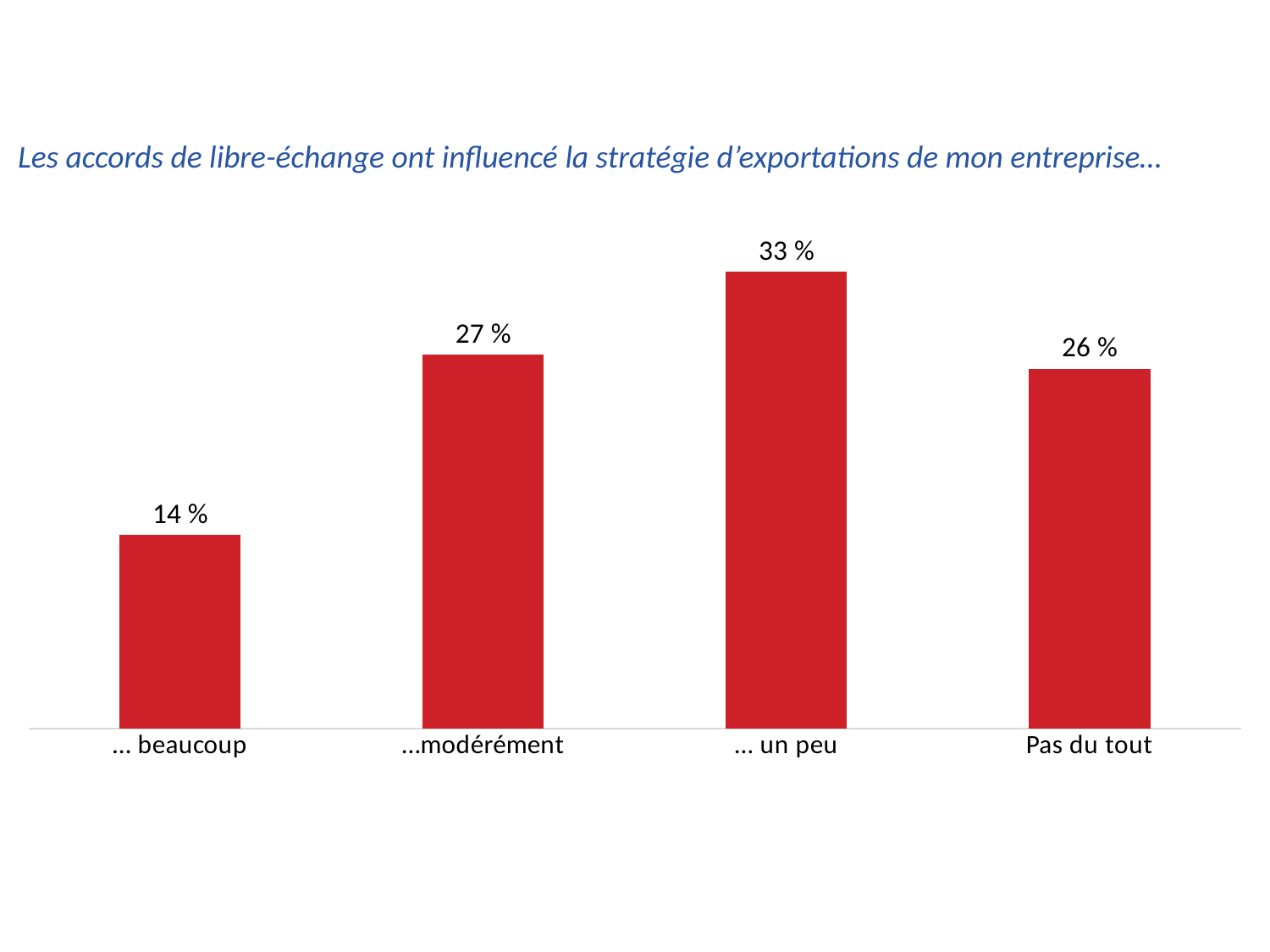
What is the difference between the values for "...modérément" and "Pas du tout"? 1 % What is the value for "Pas du tout"? 26 % Which category has the highest value? ... un peu What is the difference between the values for "... un peu" and "... beaucoup"? 19 % What colour are the bars in the chart? Red What is the value for "... beaucoup"? 14 % How many categories are shown on the chart? 4 What is the value for "... un peu"? 33 % Which category has the lowest value? ... beaucoup What is the value for "...modérément"? 27 % What kind of chart is shown on the slide? Bar chart Which is larger, the value for "...modérément" or the value for "... beaucoup"? ...modérément